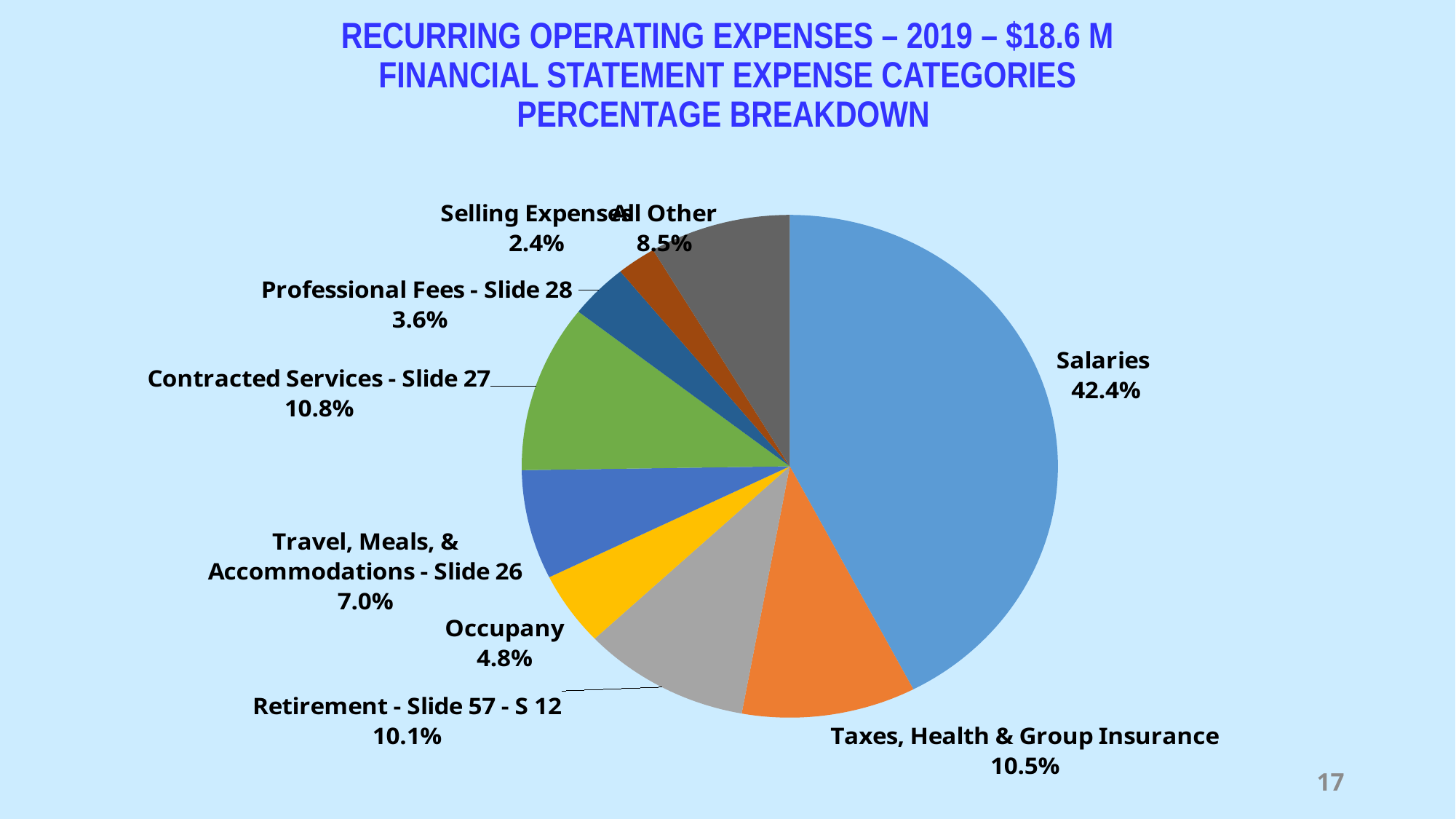
What kind of chart is shown on the slide? pie chart What is the difference in percentage points between Salaries and Contracted Services - Slide 27? 31.6 Which expense category has the smallest share of the pie? Selling Expenses What percentage is shown for Taxes, Health & Group Insurance? 10.5% What percentage is shown for Professional Fees - Slide 28? 3.6% What percentage is shown for Travel, Meals, & Accommodations - Slide 26? 7.0% What percentage is shown for Contracted Services - Slide 27? 10.8% Which expense category has the largest share of the pie? Salaries What percentage is shown for Retirement - Slide 57 - S 12? 10.1% How many expense categories are shown in the pie chart? 9 What percentage of recurring operating expenses is Salaries? 42.4% Which is larger, the share for Occupany or the share for All Other? All Other